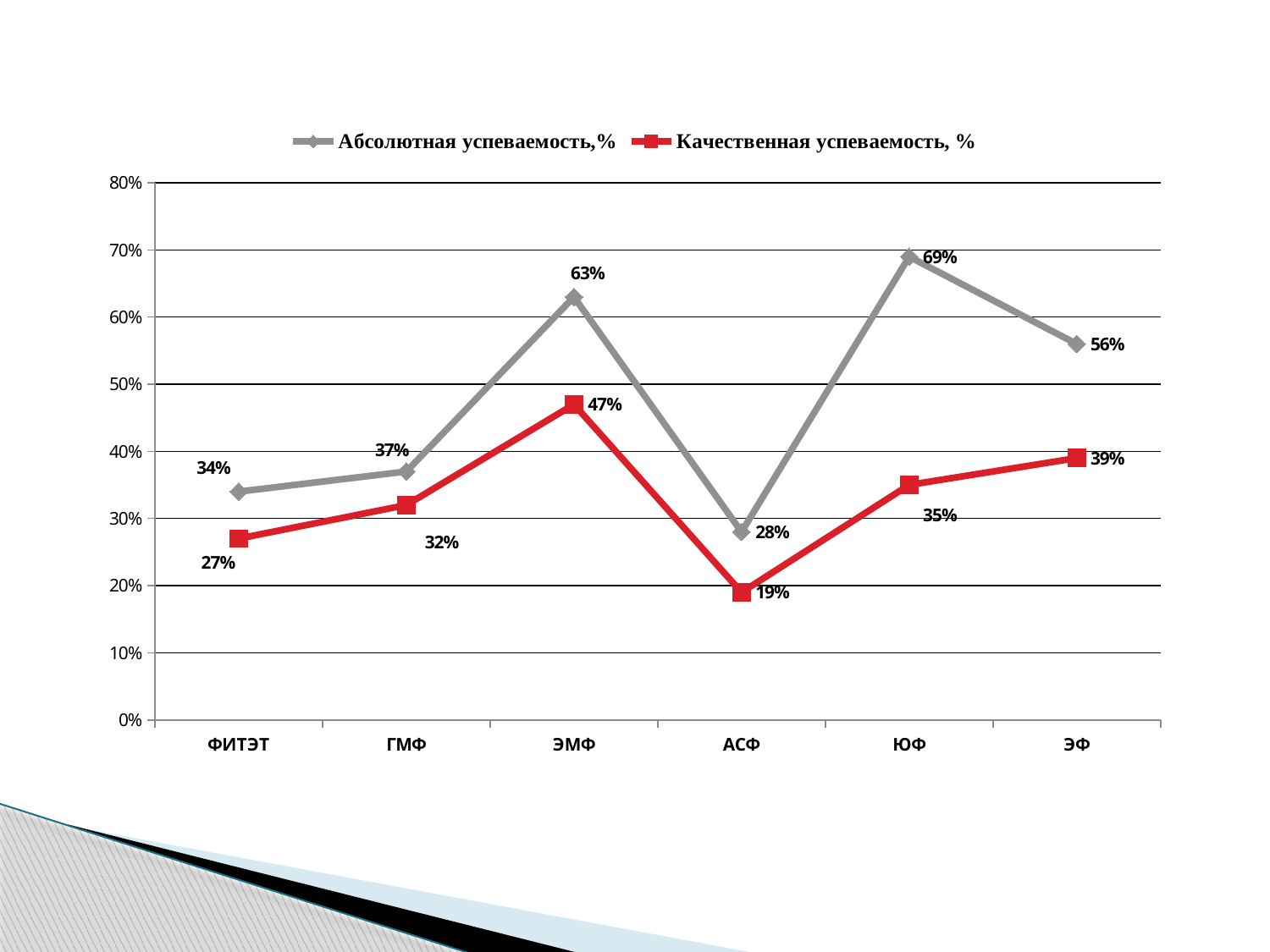
Which category has the lowest value for Качественная успеваемость, %? АСФ What kind of chart is shown on the slide? line chart Which category has the highest value for Абсолютная успеваемость,%? ЮФ What is the value of Абсолютная успеваемость,% for ЭМФ? 63% What is the difference between Абсолютная успеваемость,% and Качественная успеваемость, % for ЭФ? 17% Does Качественная успеваемость, % rise or fall from ФИТЭТ to ЭМФ? rise What is the value of Качественная успеваемость, % for ЮФ? 35% How many categories are shown on the x axis? 6 What colour is the line for Качественная успеваемость, %? red Which is larger: Абсолютная успеваемость,% for ГМФ or Абсолютная успеваемость,% for ЭФ? ЭФ What is the value of Качественная успеваемость, % for АСФ? 19% How many series does the legend list? 2